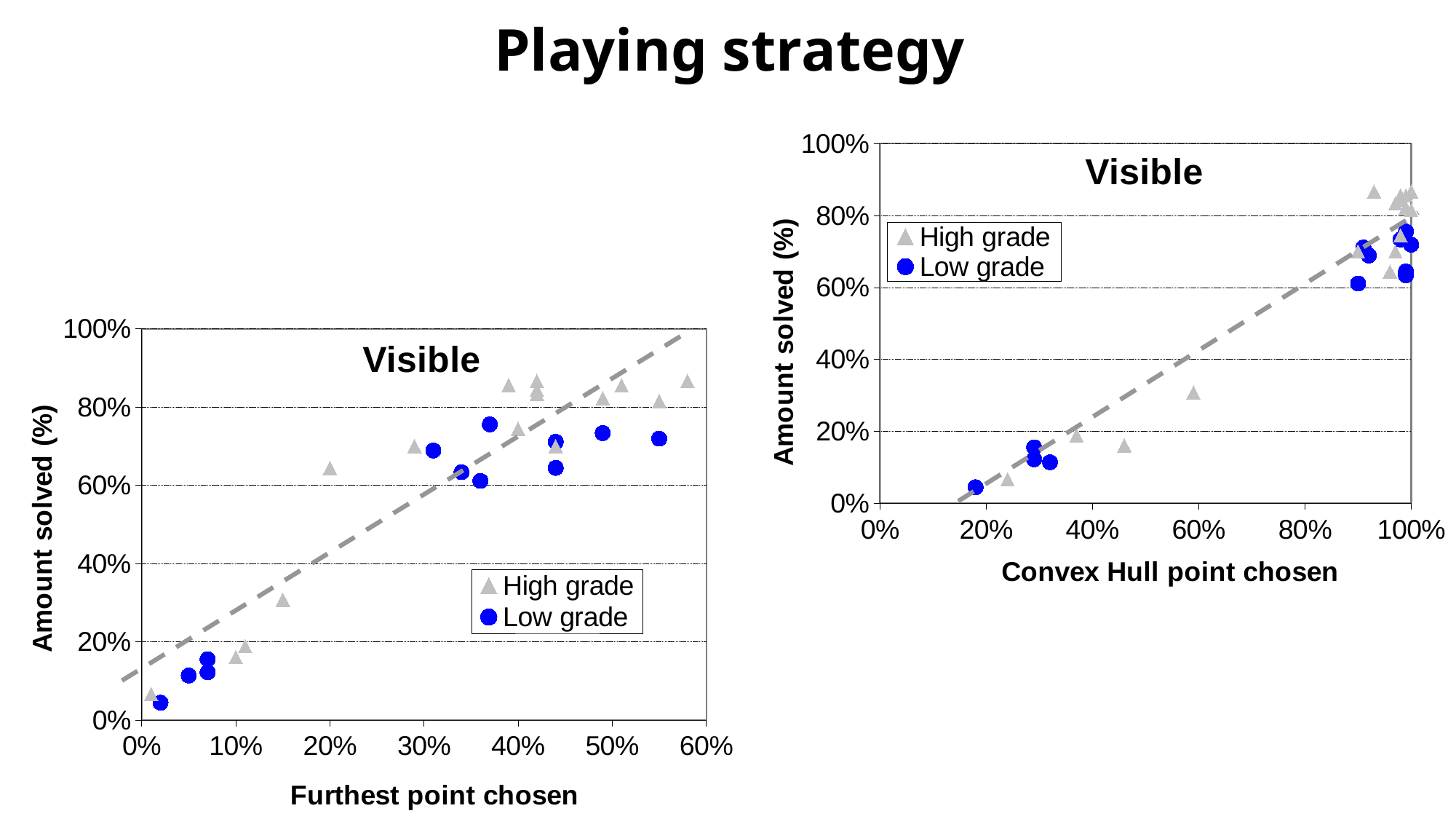
In the right chart (Convex Hull point chosen), does the amount solved rise or fall as the convex hull point chosen percentage increases? rise In the left chart (Furthest point chosen), are the Low grade points below 10% on the x axis greater or less than 20% amount solved? less In the left chart (Furthest point chosen), does the amount solved rise or fall as the furthest point chosen percentage increases? rise In the left chart (Furthest point chosen), what is the maximum value shown on the x axis? 60% In the right chart (Convex Hull point chosen), are the Low grade points near 100% on the x axis greater or less than 40% amount solved? greater How many series does the legend of the left chart (Furthest point chosen) list? 2 How many series does the legend of the right chart (Convex Hull point chosen) list? 2 In the right chart (Convex Hull point chosen), what is the maximum value shown on the x axis? 100% What kind of chart is the left chart titled "Visible" with x axis "Furthest point chosen"? scatter chart What kind of chart is the right chart with x axis "Convex Hull point chosen"? scatter chart What is the x-axis title of the right chart? Convex Hull point chosen What is the x-axis title of the left chart? Furthest point chosen